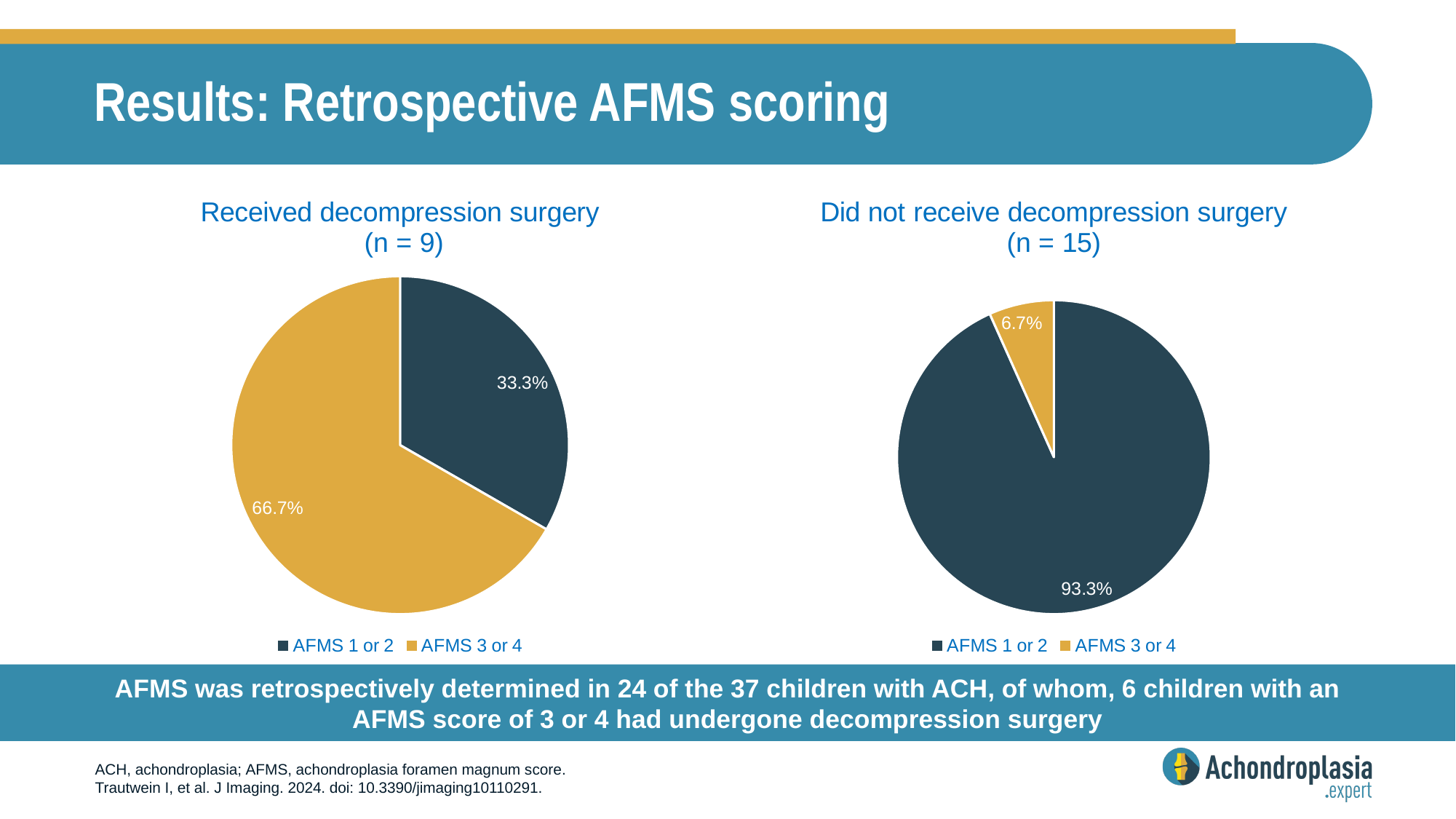
In the 'Received decompression surgery (n = 9)' chart, what colour represents AFMS 3 or 4? Gold/yellow In the 'Did not receive decompression surgery (n = 15)' chart, what percentage is shown for AFMS 1 or 2? 93.3% What type of chart is used for the 'Received decompression surgery (n = 9)' data? Pie chart In the 'Received decompression surgery (n = 9)' chart, what percentage is shown for AFMS 3 or 4? 66.7% In the 'Did not receive decompression surgery (n = 15)' chart, what percentage is shown for AFMS 3 or 4? 6.7% In the 'Received decompression surgery (n = 9)' chart, what is the difference in percentage points between AFMS 3 or 4 and AFMS 1 or 2? 33.4 In the 'Did not receive decompression surgery (n = 15)' chart, which category has the smallest slice? AFMS 3 or 4 Which is larger: the AFMS 1 or 2 share in the 'Received decompression surgery' chart or the AFMS 1 or 2 share in the 'Did not receive decompression surgery' chart? Did not receive decompression surgery In the 'Did not receive decompression surgery (n = 15)' chart, what is the difference in percentage points between AFMS 1 or 2 and AFMS 3 or 4? 86.6 In the 'Received decompression surgery (n = 9)' chart, which category has the largest slice? AFMS 3 or 4 How many categories does the legend list for the 'Did not receive decompression surgery (n = 15)' chart? 2 In the 'Received decompression surgery (n = 9)' chart, what percentage is shown for AFMS 1 or 2? 33.3%